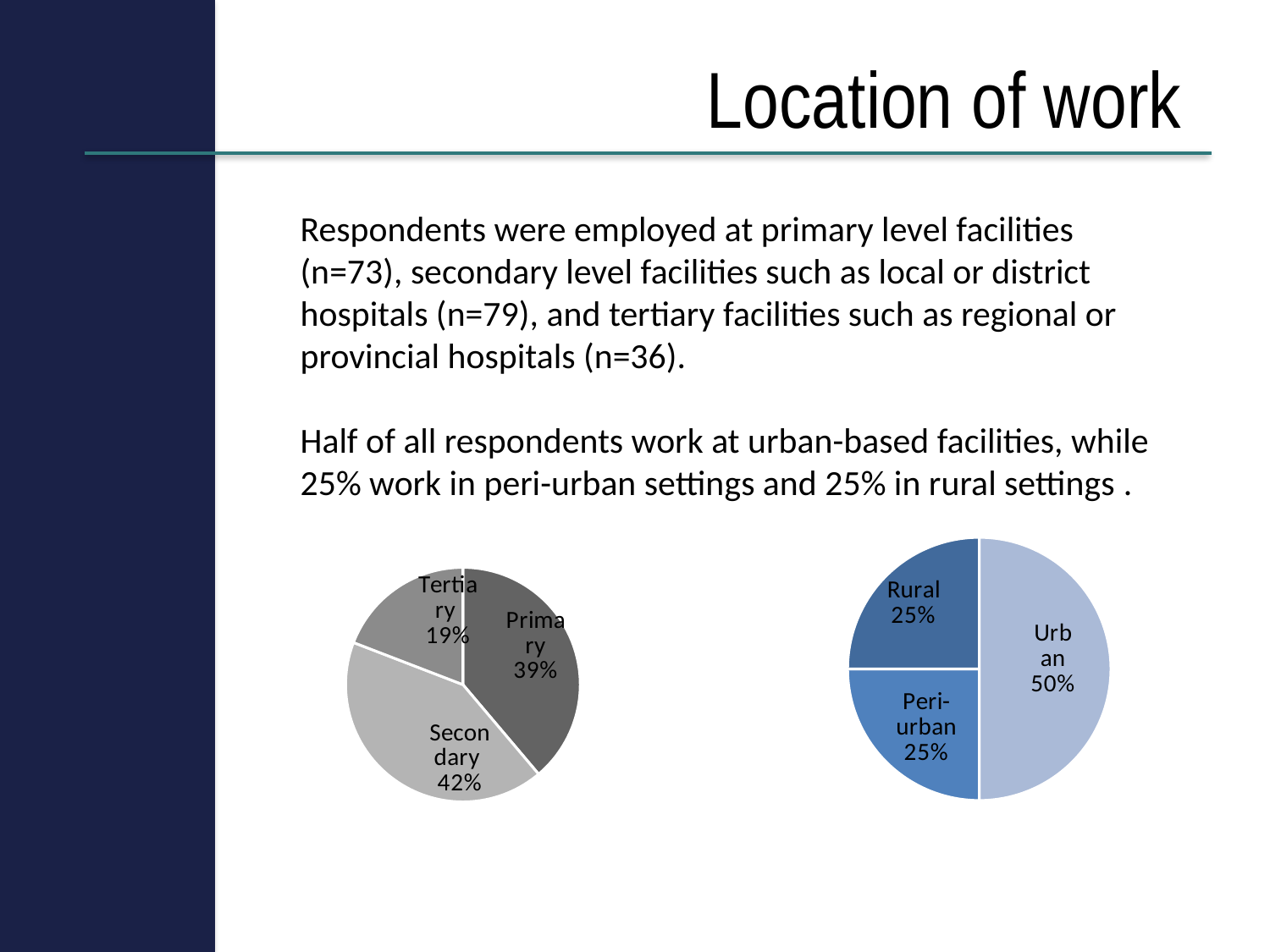
In the left pie chart, how many slices are there? 3 In the right pie chart, which location has the largest slice? Urban In the left pie chart, what share of respondents work at secondary level facilities? 42% What type of chart is shown on the right of the slide? Pie chart In the left pie chart, which facility level has the largest slice? Secondary In the right pie chart, what share of respondents work in rural settings? 25% In the right pie chart, what share of respondents work at urban facilities? 50% In the left pie chart, what is the difference between the Secondary and Primary shares? 3% In the left pie chart, is the Primary share larger or smaller than the Tertiary share? Larger In the right pie chart, what is the difference between the Urban and Peri-urban shares? 25% In the left pie chart, which facility level has the smallest slice? Tertiary In the left pie chart, what share of respondents work at tertiary facilities? 19%